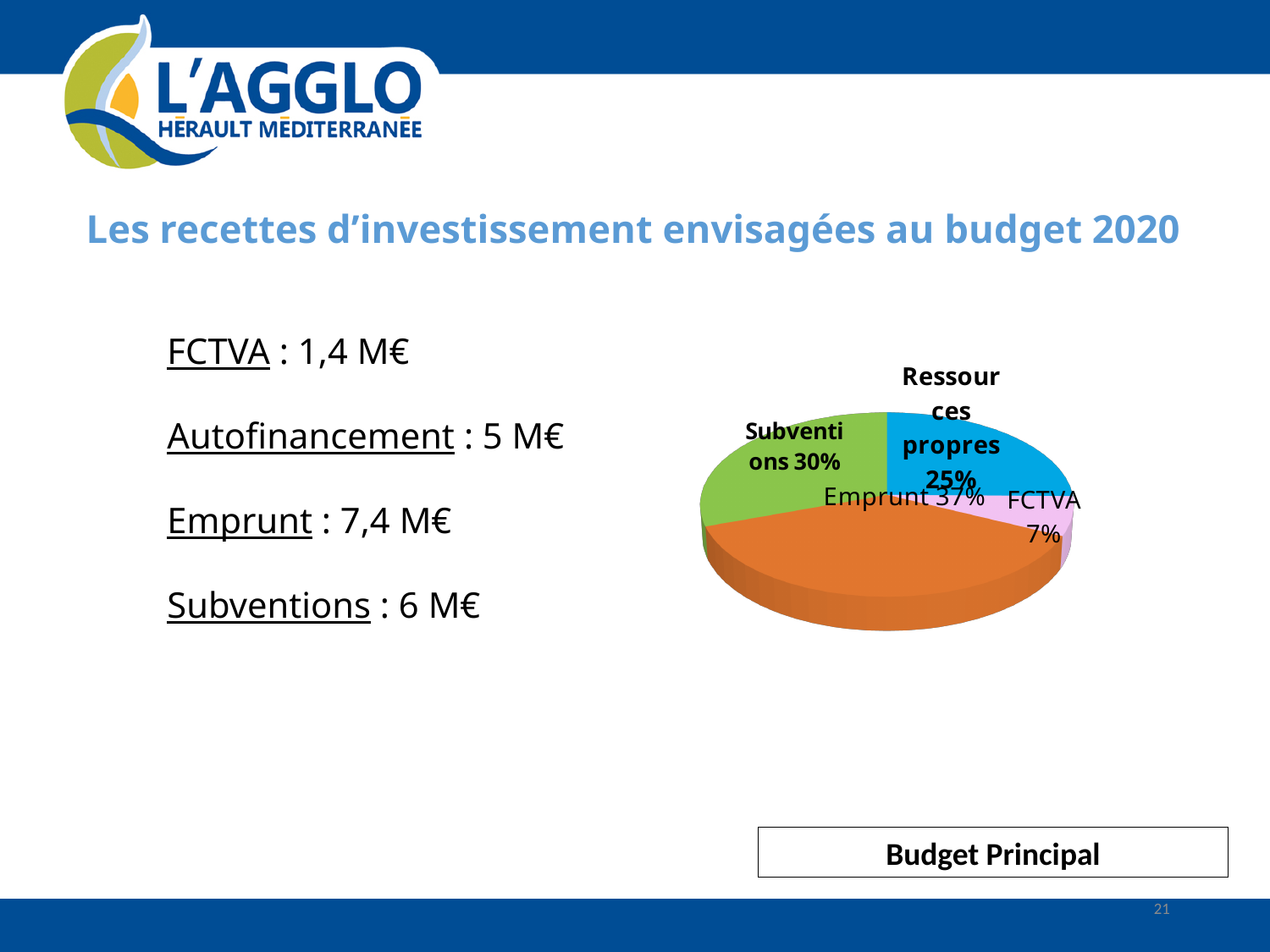
Which category has the smallest slice of the pie? FCTVA What share of the pie does Emprunt represent? 37% What colour is the Emprunt slice of the pie? Orange How many slices does the pie chart have? 4 What percentage is shown for Subventions? 30% What share of the pie does FCTVA represent? 7% What is the difference in percentage points between Subventions and FCTVA? 23 What percentage is shown for Ressources propres? 25% What type of chart is shown on the slide? Pie chart Which is larger, the share for Subventions or the share for Ressources propres? Subventions Which category has the largest slice of the pie? Emprunt What is the difference in percentage points between Emprunt and Subventions? 7